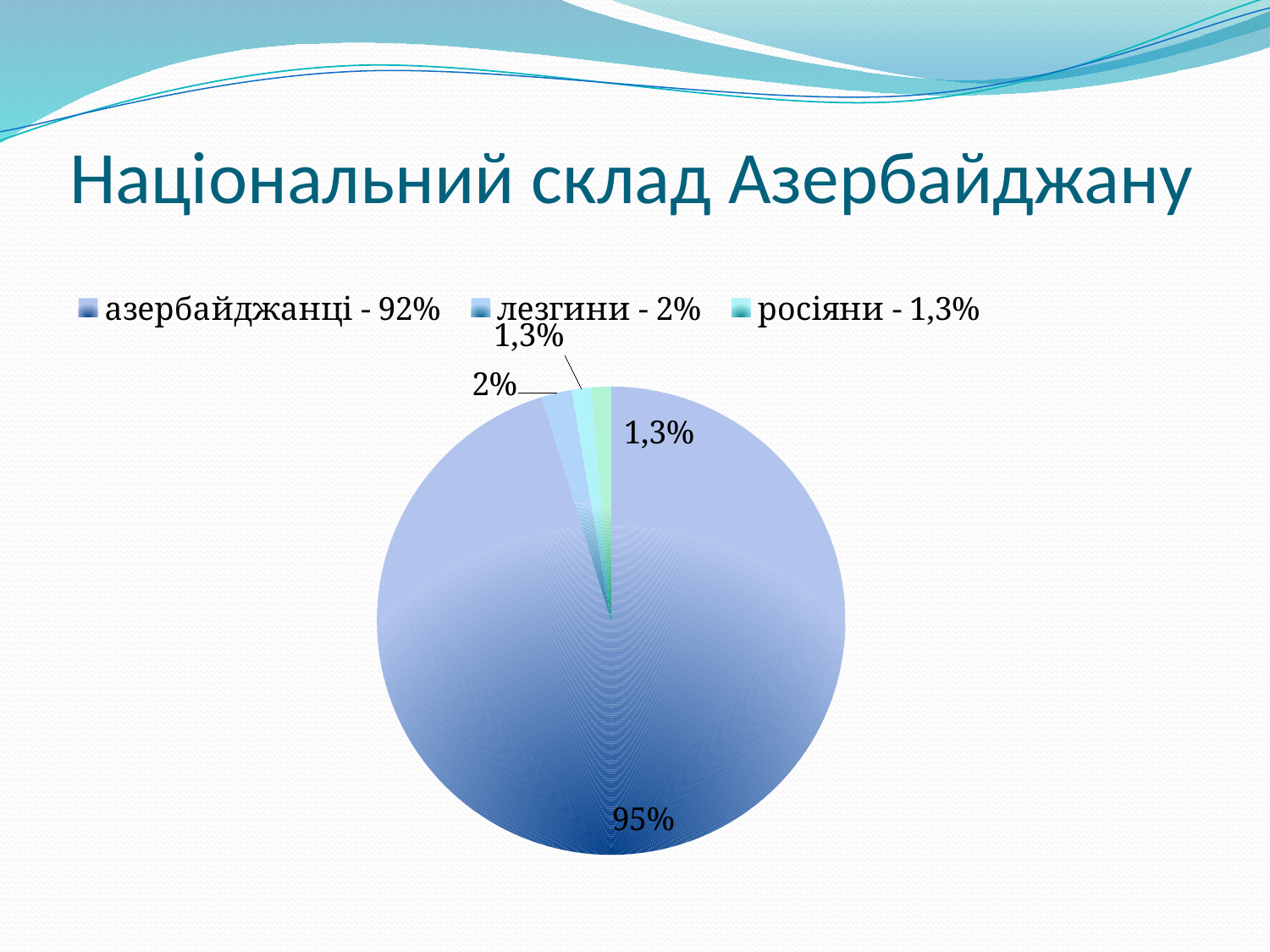
What data label is printed on the largest slice of the pie chart? 95% How many data labels are printed on the pie chart? 4 What percentage is given for росіяни in the legend? 1,3% What is the title of the slide with the pie chart? Національний склад Азербайджану Is the largest slice of the pie chart greater or less than 50%? greater What percentage is given for лезгини in the legend? 2% How many entries does the legend of the pie chart list? 3 Which group has the largest slice of the pie chart? азербайджанці What percentage is given for азербайджанці in the legend? 92% What kind of chart is shown on the slide? pie chart According to the legend, what is the difference between the share of лезгини and the share of росіяни? 0,7% Which is larger according to the legend, лезгини or росіяни? лезгини